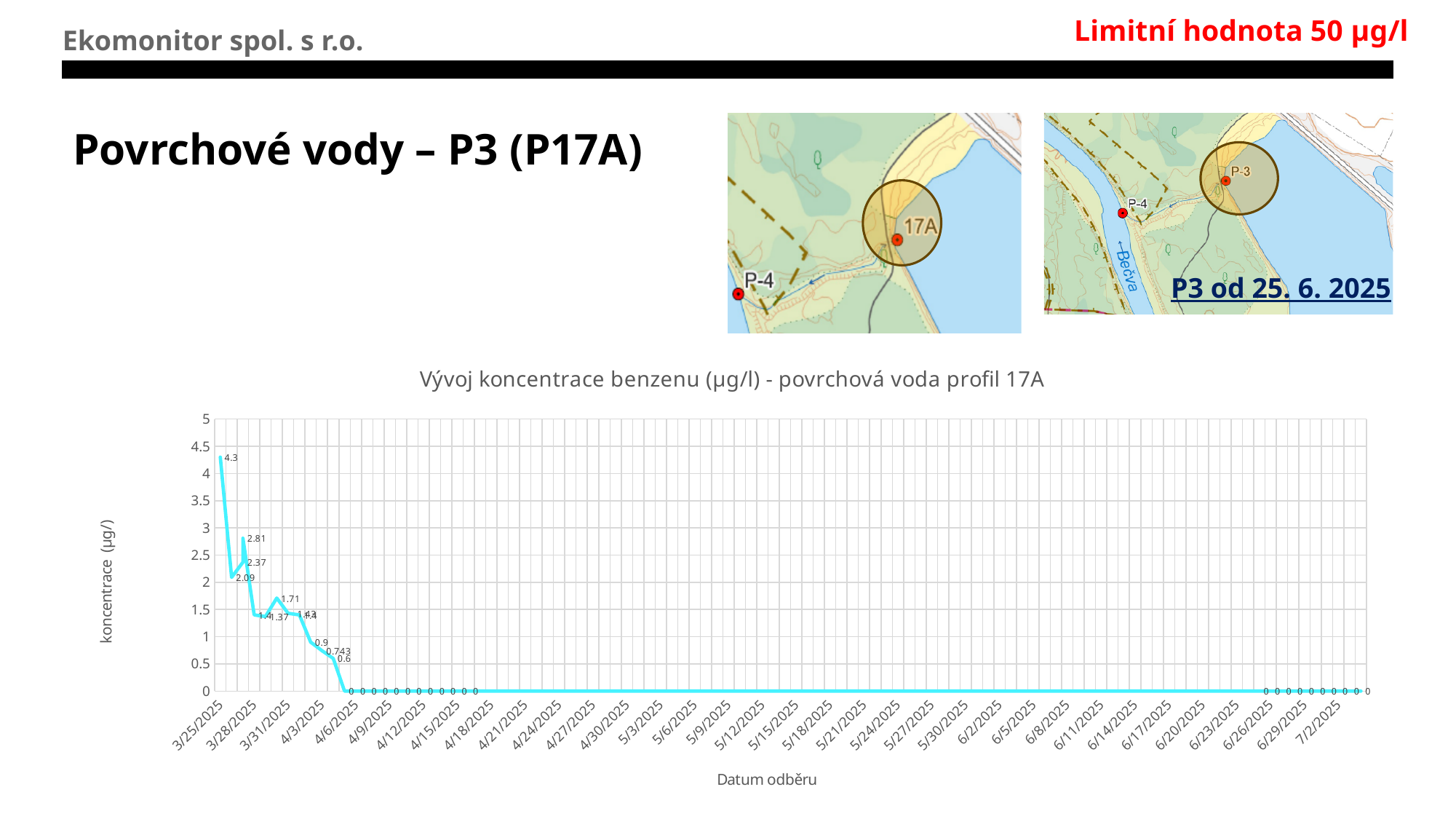
What is the benzene concentration plotted for 3/25/2025? 4.3 What kind of chart is shown on the slide? line chart On which date does the chart reach its highest value? 3/25/2025 What is the title of the chart? Vývoj koncentrace benzenu (µg/l) - povrchová voda profil 17A Is the value for 3/25/2025 greater or less than 4? greater What is the highest value plotted on the chart? 4.3 Do the plotted values generally rise or fall along the x axis? fall What is the difference between the first plotted value (4.3) and the value labelled 2.81? 1.49 What is the label of the x axis of the chart? Datum odběru What is the lowest value plotted on the chart? 0 What is the value plotted for 7/2/2025? 0